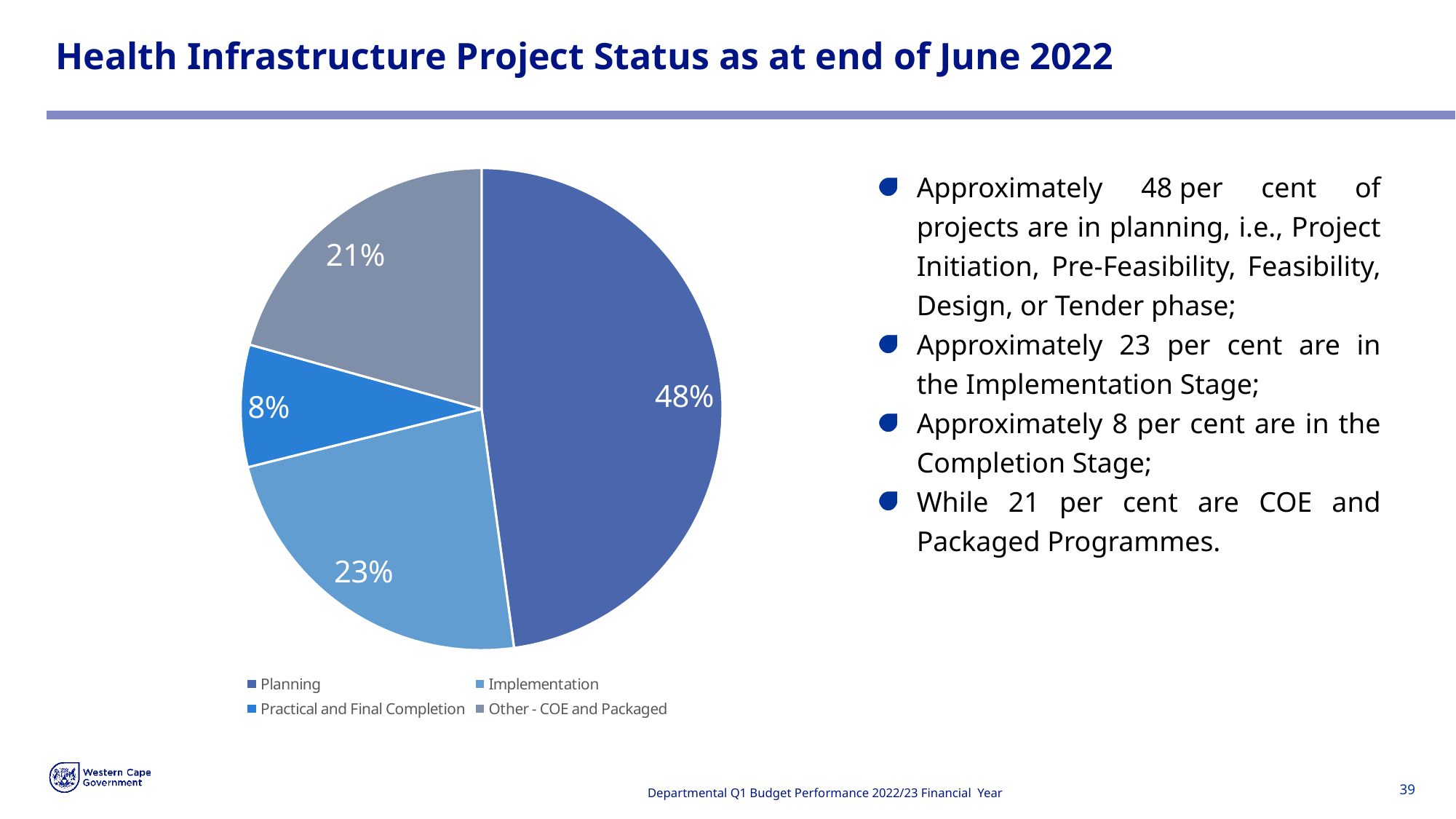
What is the difference in percentage points between the Planning and Implementation slices? 25 Which is larger, the Implementation slice or the Other - COE and Packaged slice? Implementation Which category has the largest slice of the pie? Planning What share of projects is in the Planning stage? 48% Which category has the smallest slice of the pie? Practical and Final Completion How many categories does the pie chart show? 4 What share of projects is in Practical and Final Completion? 8% What share of projects falls under Other - COE and Packaged? 21% What colour is the Other - COE and Packaged slice? Grey How many entries does the legend list? 4 What share of projects is in the Implementation stage? 23% What kind of chart is shown on the slide? Pie chart